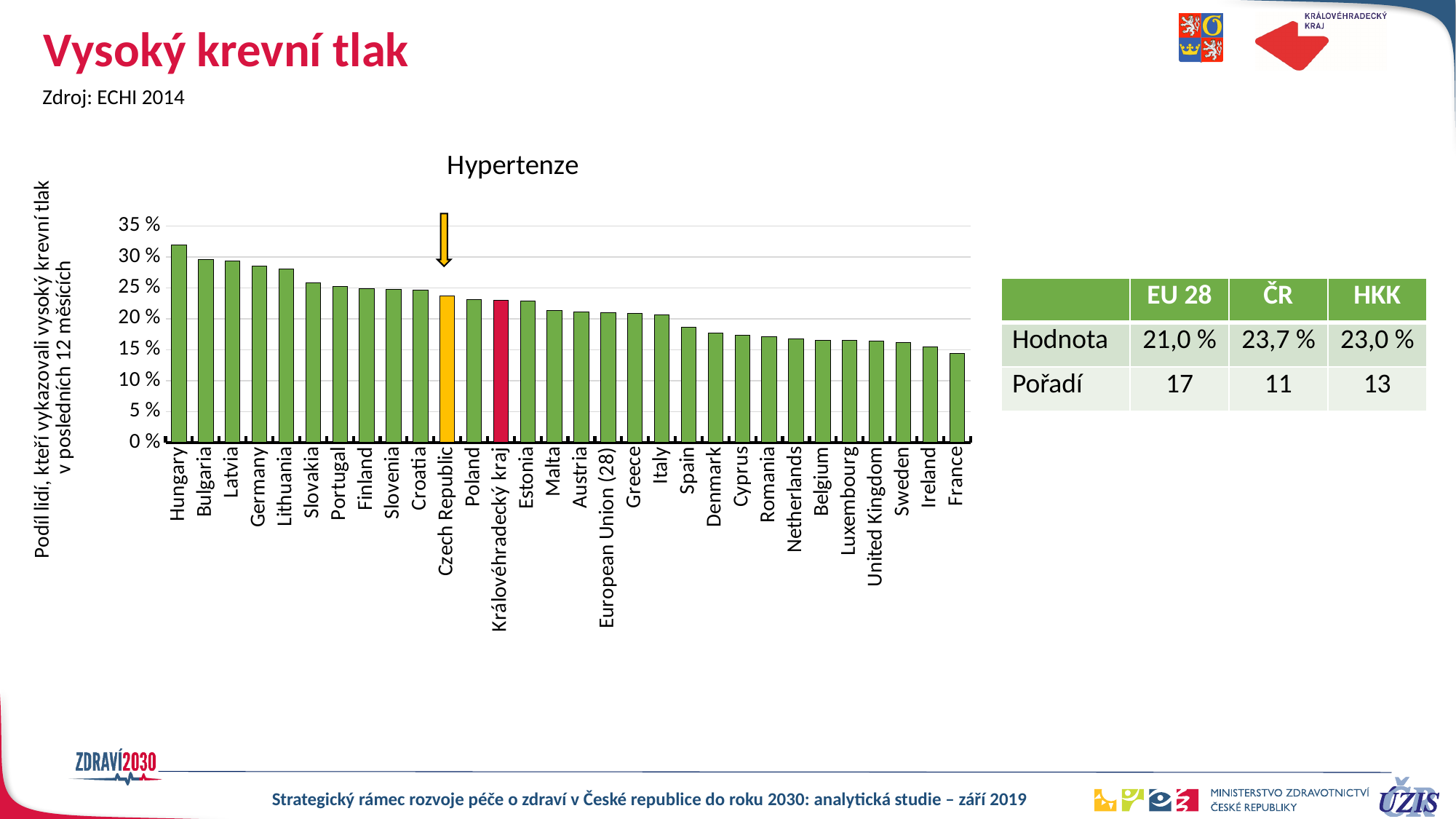
Do the values rise or fall from left to right along the x axis? fall What is the value for Královéhradecký kraj (HKK) according to the slide? 23,0 % Is the value for Hungary greater or less than 30 %? greater Is the value for Spain greater or less than 20 %? less What is the title of the chart? Hypertenze What type of chart is shown on the slide? bar chart How many categories (bars) are plotted in the chart? 30 What is the difference between the values for Czech Republic and European Union (28)? 2,7 % Which country has the highest share of people reporting high blood pressure in the chart? Hungary What is the value for Czech Republic (ČR) according to the slide? 23,7 % What is the value for European Union (28) according to the slide? 21,0 % Which country has the lowest value in the chart? France